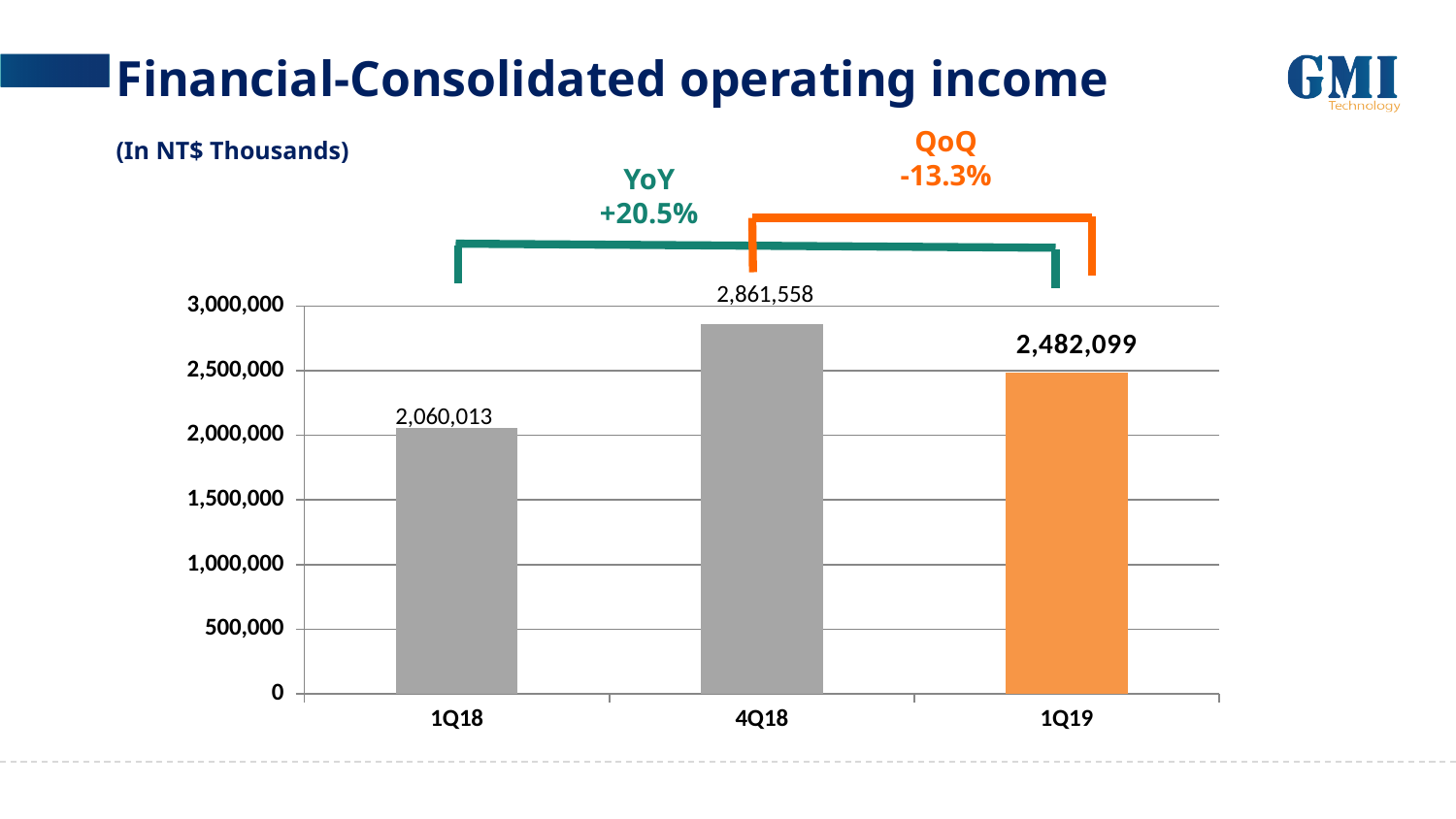
What is the difference between the operating income in 4Q18 and 1Q19? 379,459 What is the QoQ change shown on the slide? -13.3% Which quarter has the highest consolidated operating income? 4Q18 Which is larger, the operating income in 1Q18 or in 1Q19? 1Q19 What is the consolidated operating income for 1Q18? 2,060,013 Which quarter has the lowest consolidated operating income? 1Q18 How many quarters are shown in the chart? 3 What is the consolidated operating income for 4Q18? 2,861,558 What is the consolidated operating income for 1Q19? 2,482,099 What kind of chart is shown on the slide? Bar chart Is the value for 4Q18 greater or less than 2,500,000? greater What is the difference between the operating income in 1Q19 and 1Q18? 422,086